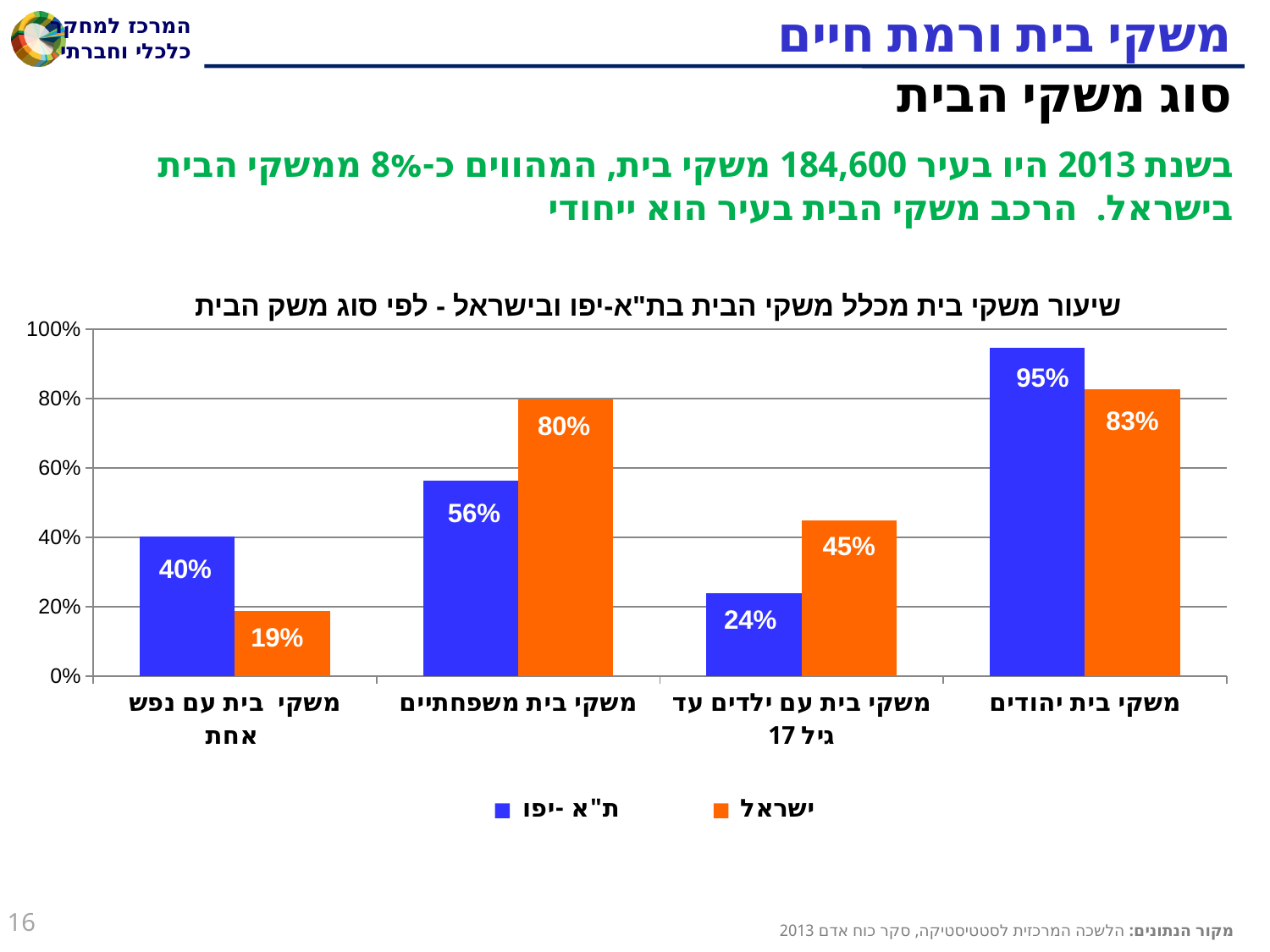
What is the value for ת"א-יפו in the category משקי בית עם ילדים עד גיל 17? 24% Which colour represents the ישראל series in the chart? orange What is the value for ישראל in the category משקי בית יהודים? 83% Which category has the lowest value for ישראל? משקי בית עם נפש אחת In the category משקי בית עם ילדים עד גיל 17, which is larger: ת"א-יפו or ישראל? ישראל What is the value for ת"א-יפו in the category משקי בית עם נפש אחת? 40% What is the value for ישראל in the category משקי בית משפחתיים? 80% What type of chart is shown on the slide? bar chart What is the difference between the ישראל and ת"א-יפו values for משקי בית משפחתיים? 24% Which category has the highest value for ת"א-יפו? משקי בית יהודים How many household-type categories are shown on the x axis? 4 How many series does the legend list? 2